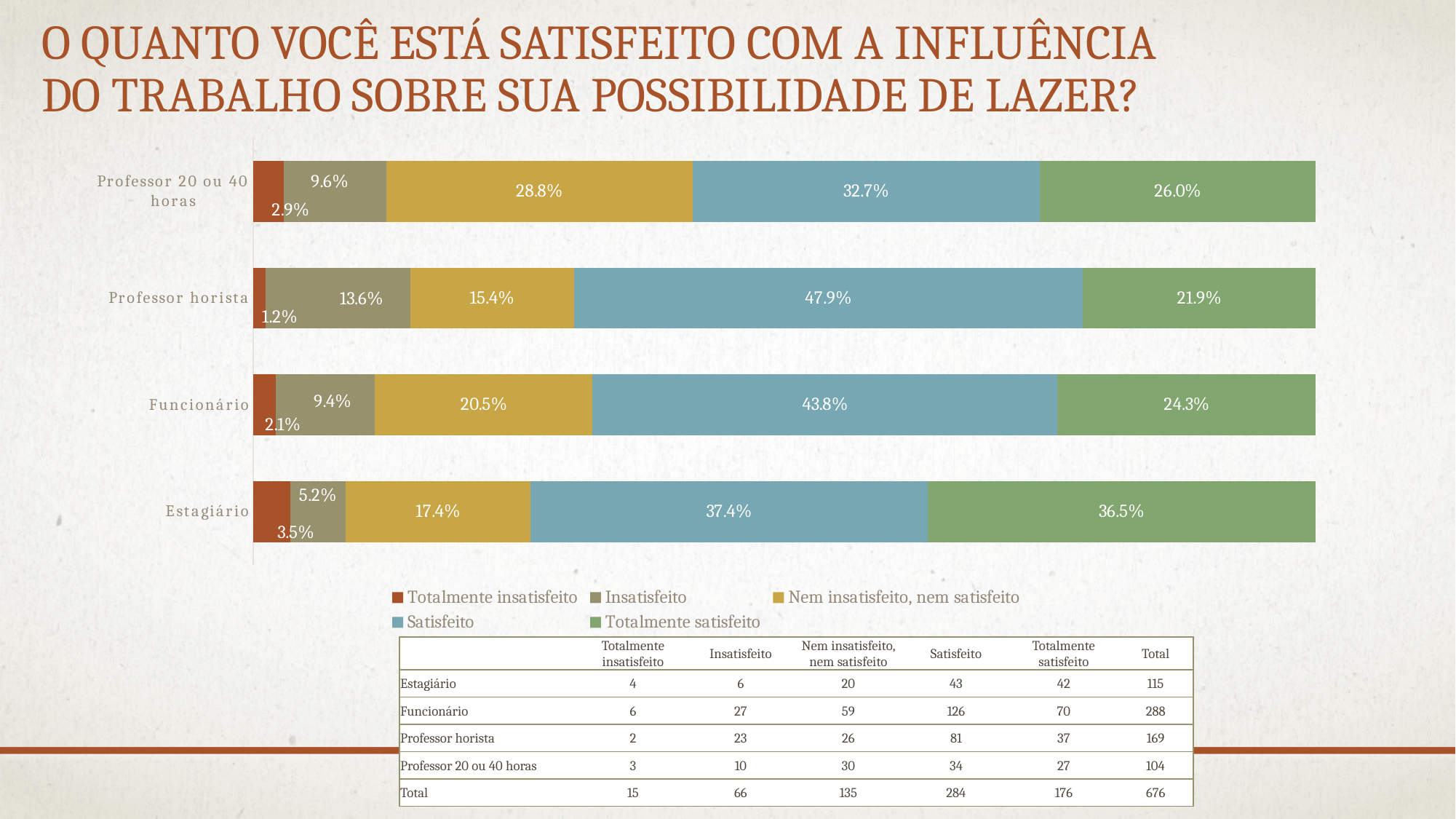
How many categories are shown on the chart? 4 Which category has the highest value for Satisfeito? Professor horista What kind of chart is shown on the slide? Stacked bar chart What is the difference between the Totalmente satisfeito values for Estagiário and Professor horista? 14.6 percentage points Which is larger: the Insatisfeito value for Professor horista or for Funcionário? Professor horista What is the value for Nem insatisfeito, nem satisfeito for Professor 20 ou 40 horas? 28.8% How many series does the legend list? 5 Which category has the lowest value for Totalmente insatisfeito? Professor horista What is the value for Satisfeito for Professor horista? 47.9% Which colour represents Totalmente satisfeito in the legend? Green What is the value for Totalmente insatisfeito for Funcionário? 2.1% What is the value for Totalmente satisfeito for Estagiário? 36.5%